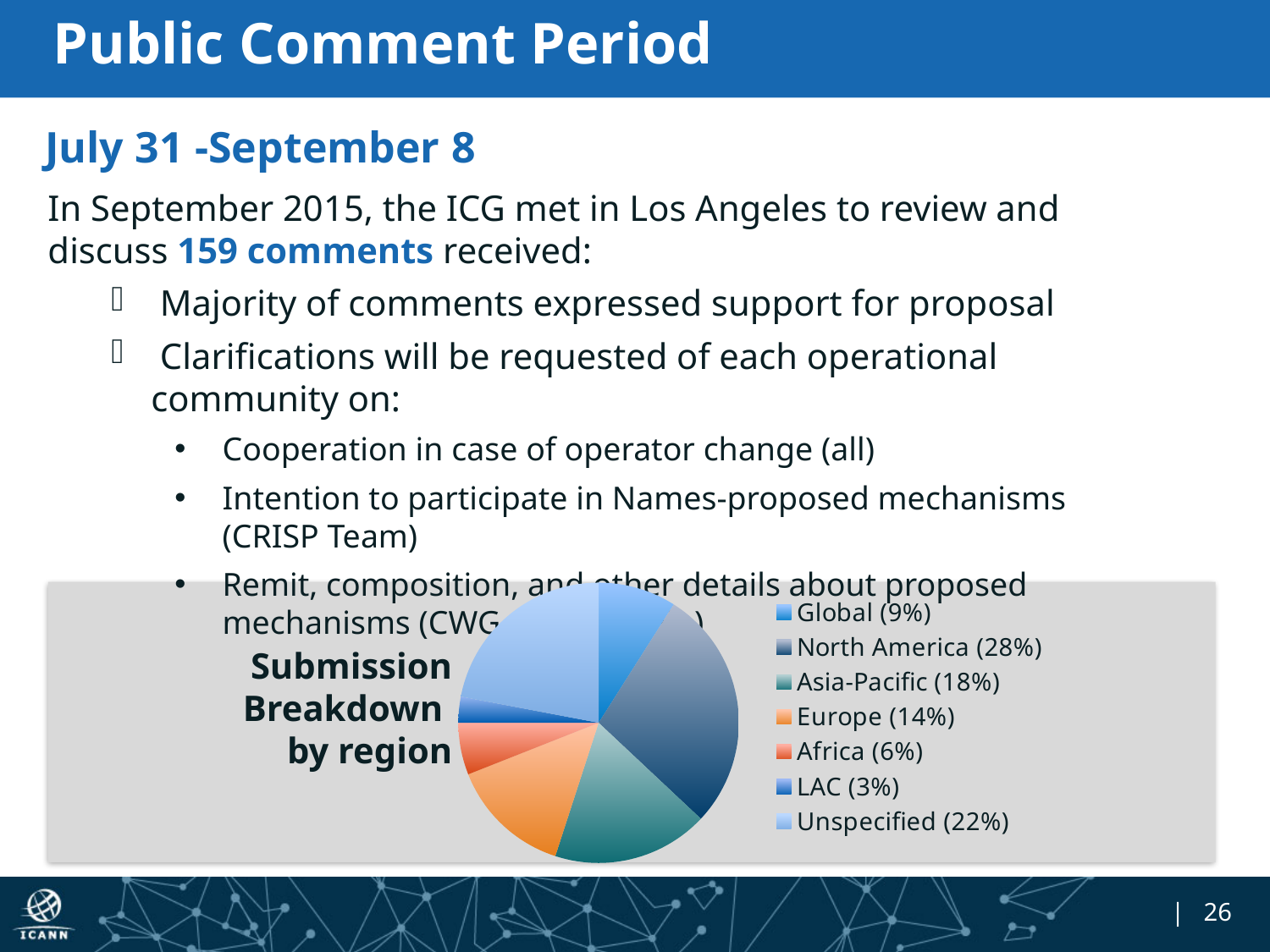
How many regions (slices) does the pie chart show? 7 What is the difference in percentage points between North America and Europe? 14 Which region has the smallest share of submissions? LAC What is the title of the pie chart? Submission Breakdown by region What share of submissions came from Asia-Pacific? 18% What share of submissions came from LAC? 3% Which region has the largest share of submissions? North America What kind of chart is shown on the slide? pie chart What share of submissions is listed as Unspecified? 22% What share of submissions came from North America? 28% What is the difference in percentage points between Global and Africa? 3 Which has a larger share of submissions, Asia-Pacific or Europe? Asia-Pacific